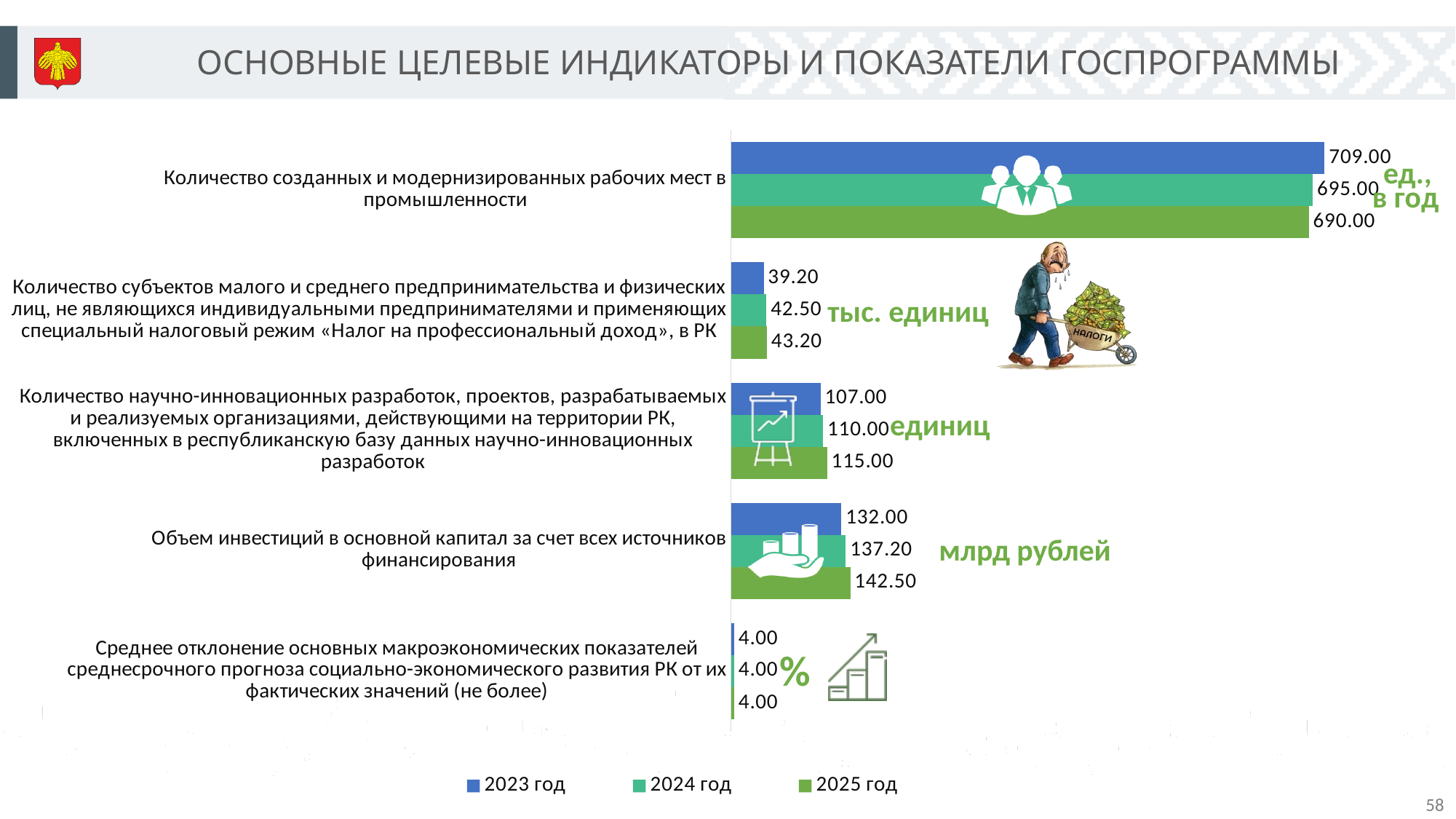
Which is larger for 'Количество научно-инновационных разработок, проектов ...': the 2023 год value or the 2024 год value? 2024 год What is the difference between the 2025 год and 2023 год values for 'Объем инвестиций в основной капитал за счет всех источников финансирования'? 10.50 What is the difference between the 2023 год and 2025 год values for 'Количество созданных и модернизированных рабочих мест в промышленности'? 19.00 What is the value for 2024 год for 'Количество субъектов малого и среднего предпринимательства ... применяющих специальный налоговый режим «Налог на профессиональный доход», в РК'? 42.50 What is the value for 2025 год for 'Количество научно-инновационных разработок, проектов ...'? 115.00 What kind of chart is shown on the slide? Bar chart How many categories (indicators) are shown in the chart? 5 Which year has the highest value for 'Количество созданных и модернизированных рабочих мест в промышленности'? 2023 год How many series does the legend list? 3 What is the value for 2025 год for 'Объем инвестиций в основной капитал за счет всех источников финансирования'? 142.50 What is the value for 2023 год for 'Количество созданных и модернизированных рабочих мест в промышленности'? 709.00 What is the value for 'Среднее отклонение основных макроэкономических показателей ...' in each of the three years? 4.00